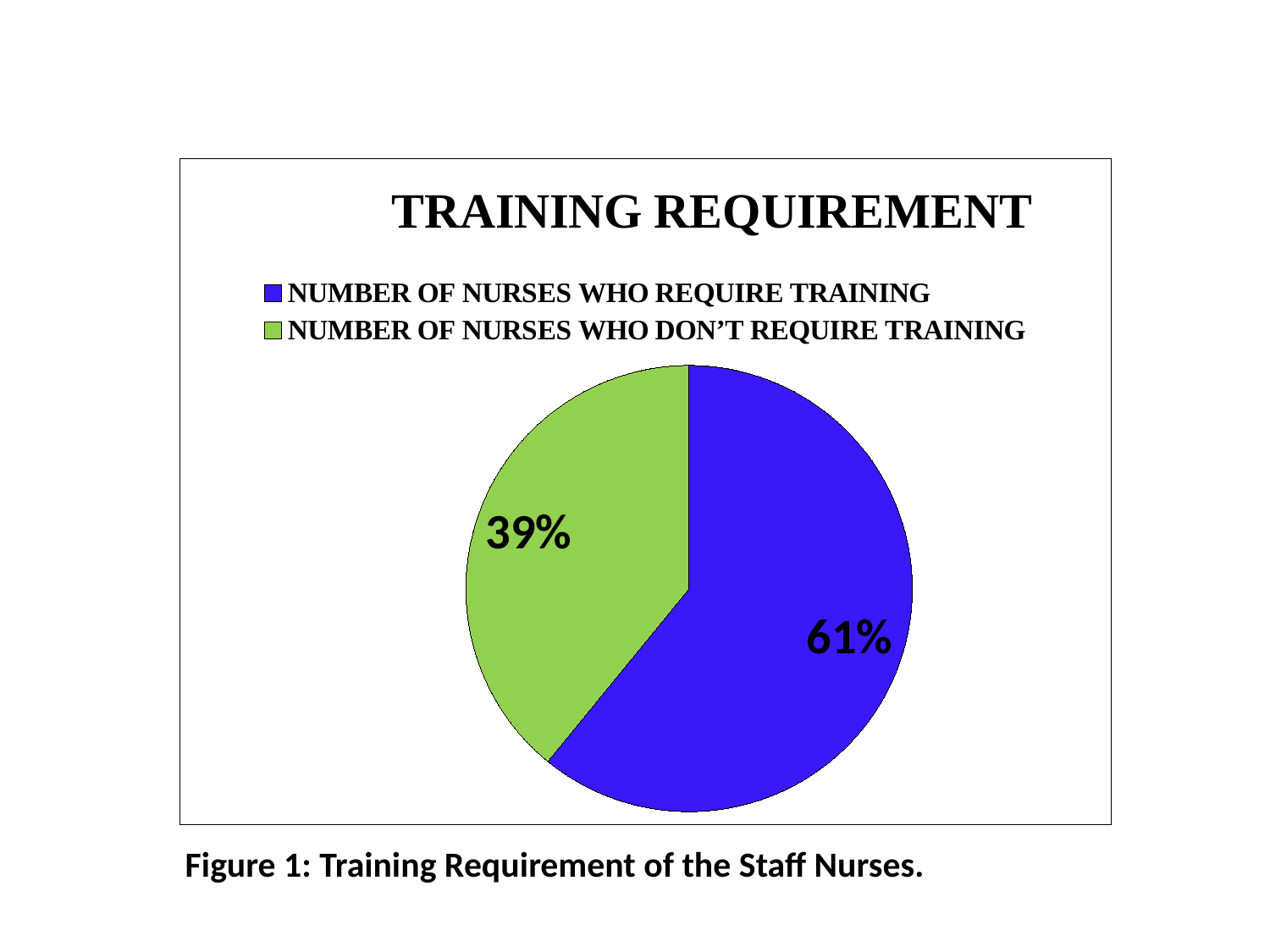
How many slices does the pie chart have? 2 Which is larger: the share of nurses who require training or the share who don't require training? NUMBER OF NURSES WHO REQUIRE TRAINING What percentage of nurses don't require training? 39% What kind of chart is shown on the slide? pie chart What is the title of the chart? TRAINING REQUIREMENT Which category has the largest share of the pie? NUMBER OF NURSES WHO REQUIRE TRAINING What is the difference in percentage points between the share of nurses who require training and those who don't? 22 Which category has the smallest share of the pie? NUMBER OF NURSES WHO DON'T REQUIRE TRAINING What percentage of nurses require training? 61% What colour is the slice for nurses who don't require training? green What share of the pie is taken by the blue slice? 61% How many entries does the legend list? 2